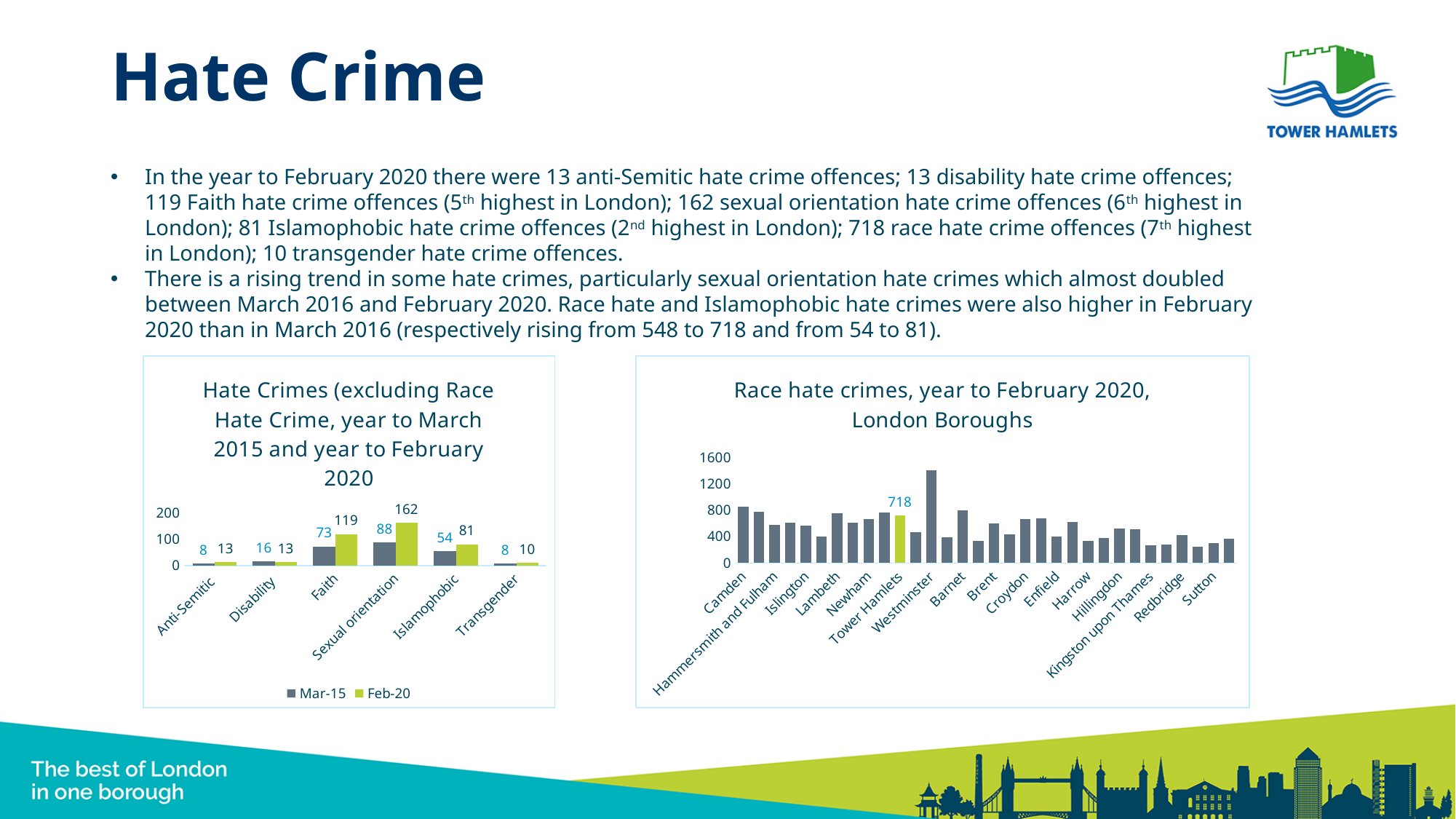
In the left chart (Hate Crimes excluding Race Hate Crime), how many series does the legend list? 2 What kind of chart is the right chart (Race hate crimes, year to February 2020, London Boroughs)? bar chart In the right chart (Race hate crimes, year to February 2020, London Boroughs), which borough has the highest value? Westminster In the left chart (Hate Crimes excluding Race Hate Crime), which category has the highest Feb-20 value? Sexual orientation In the left chart (Hate Crimes excluding Race Hate Crime), is the Mar-15 value for Disability larger or smaller than its Feb-20 value? larger In the left chart (Hate Crimes excluding Race Hate Crime), what is the Mar-15 value for Islamophobic? 54 In the left chart (Hate Crimes excluding Race Hate Crime), how many categories are shown on the x axis? 6 In the left chart (Hate Crimes excluding Race Hate Crime), what are the two legend entries? Mar-15 and Feb-20 In the left chart (Hate Crimes excluding Race Hate Crime), what is the Feb-20 value for Sexual orientation? 162 In the right chart (Race hate crimes, year to February 2020, London Boroughs), is the value for Westminster greater or less than 1200? greater In the left chart (Hate Crimes excluding Race Hate Crime), what is the difference between the Feb-20 and Mar-15 values for Faith? 46 In the right chart (Race hate crimes, year to February 2020, London Boroughs), what is the value for Tower Hamlets? 718